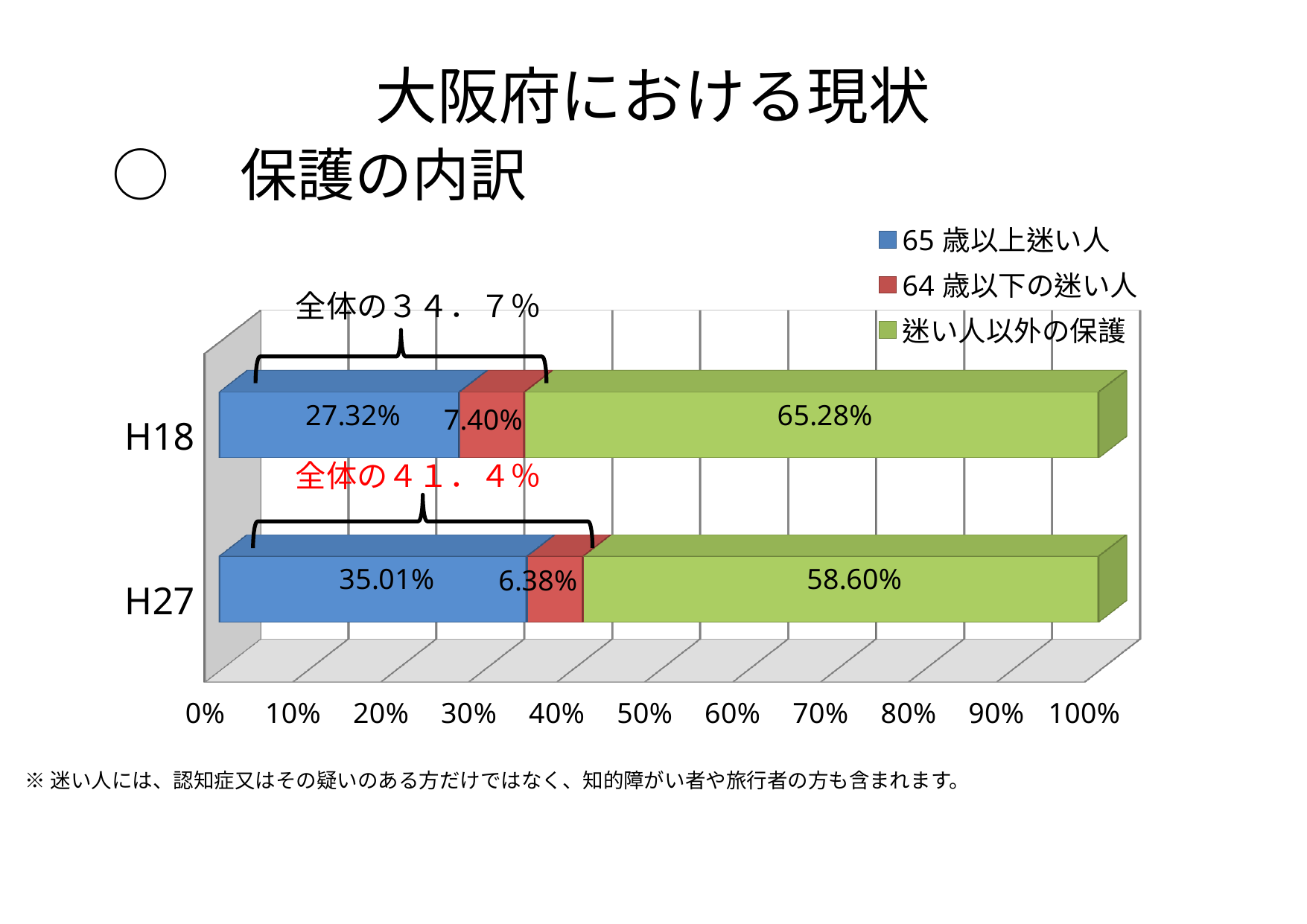
What is the value for 迷い人以外の保護 in H27? 58.60% What is the value for 迷い人以外の保護 in H18? 65.28% What is the value for 64歳以下の迷い人 in H27? 6.38% How many categories (years) are shown on the chart? 2 Which series has the largest value in H18? 迷い人以外の保護 What is the value for 65歳以上迷い人 in H18? 27.32% What is the difference between the 65歳以上迷い人 values for H27 and H18? 7.69% Which year has the larger value for 65歳以上迷い人, H18 or H27? H27 How many series does the legend list? 3 What is the difference between the 迷い人以外の保護 values for H18 and H27? 6.68% What kind of chart is shown on the slide? Stacked bar chart Which series has the smallest value in H27? 64歳以下の迷い人